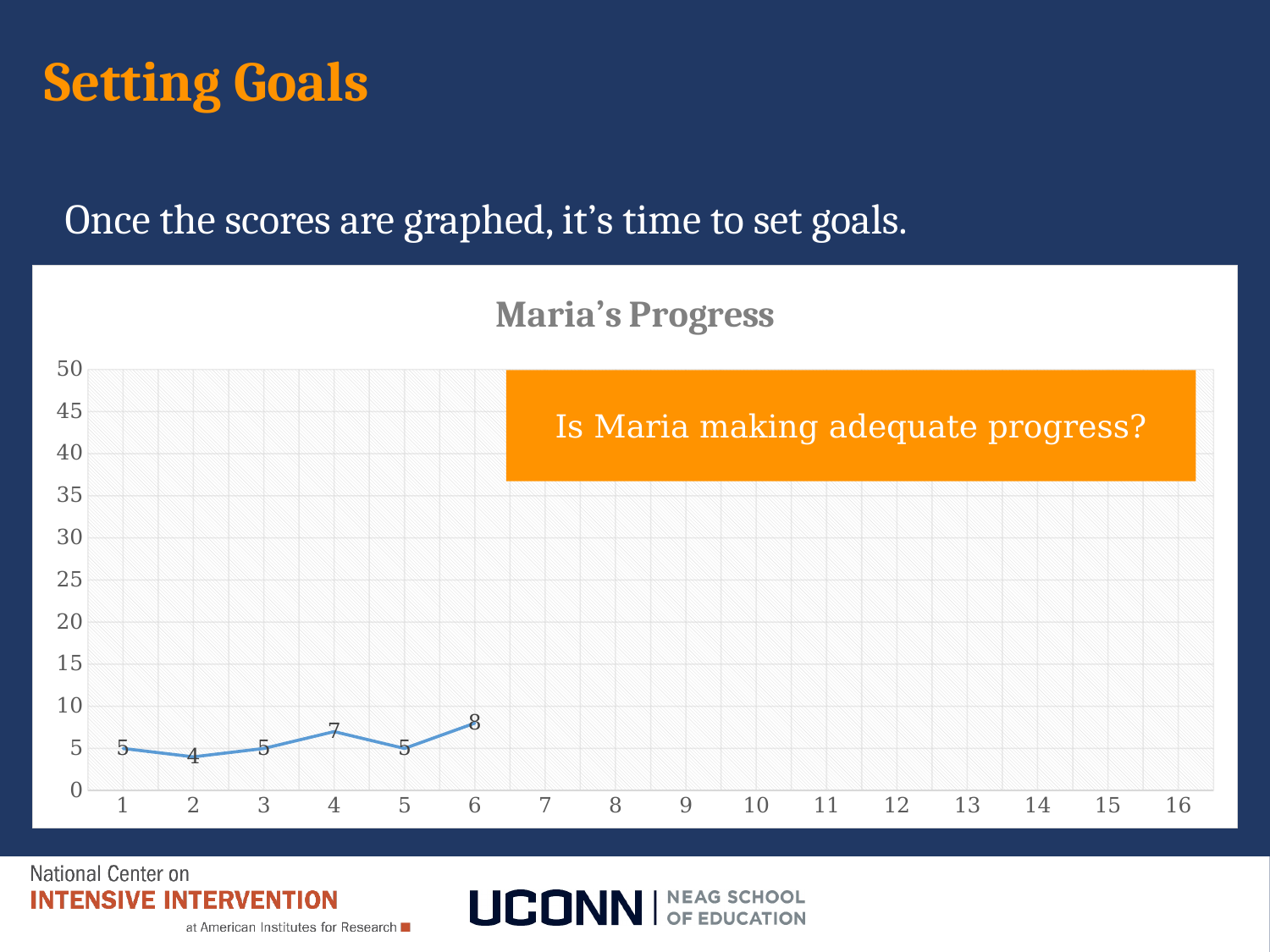
What is the difference between Maria's score at point 6 and her score at point 2? 4 How many data points are plotted on the line? 6 What is the title of the chart? Maria's Progress What is Maria's score at point 6? 8 What is Maria's score at point 4? 7 What is Maria's score at point 1? 5 What is the highest value shown on the y-axis? 50 At which x-axis point is Maria's score the lowest? 2 At which x-axis point is Maria's score the highest? 6 What kind of chart is shown on the slide? line chart Is Maria's score at point 6 greater or less than 10? less Which is larger, Maria's score at point 4 or at point 5? point 4